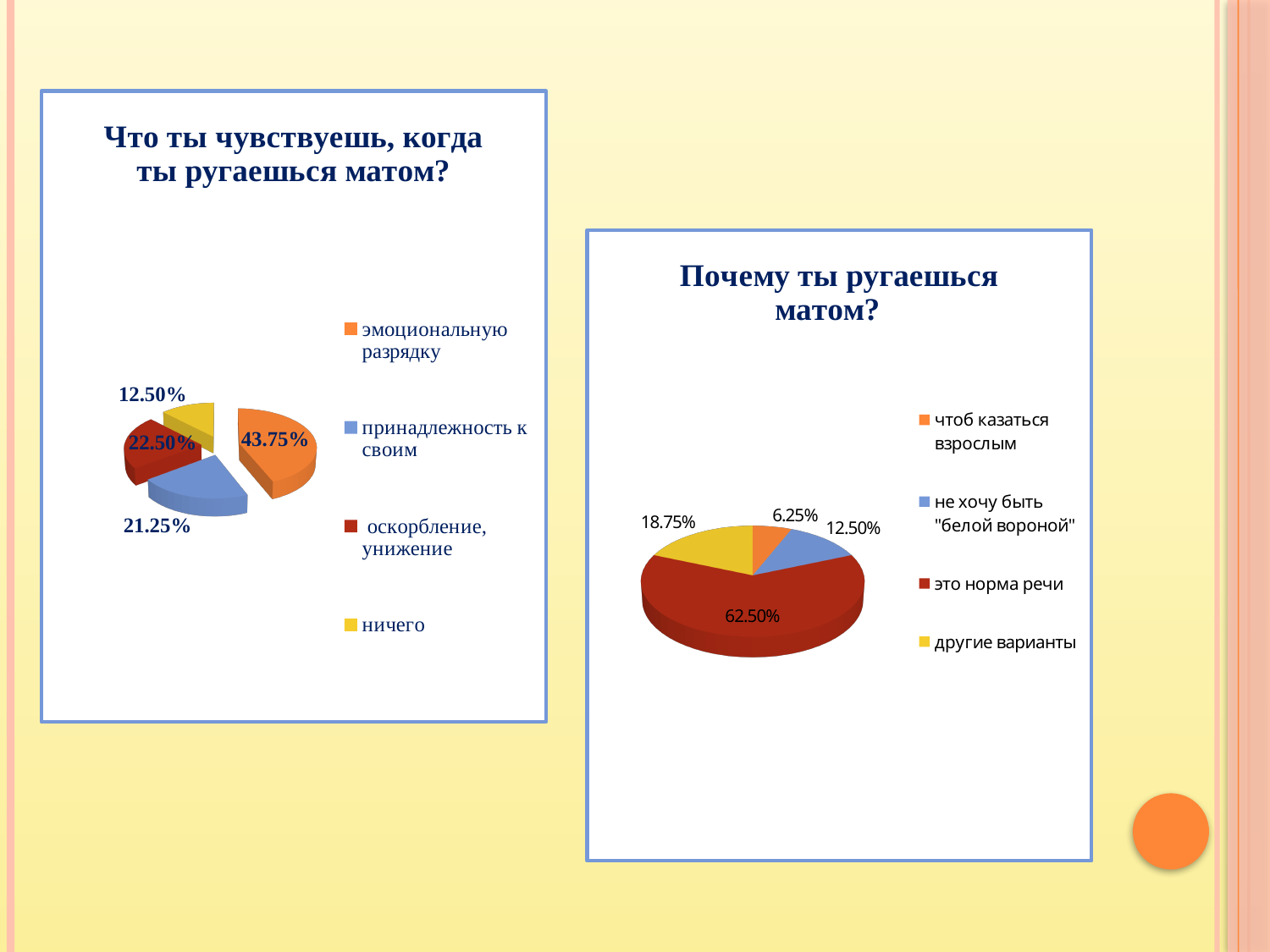
In the chart titled "Почему ты ругаешься матом?", what is the difference between the shares for "это норма речи" and "другие варианты"? 43.75% What type of chart is the chart titled "Почему ты ругаешься матом?"? pie chart In the chart titled "Что ты чувствуешь, когда ты ругаешься матом?", which category has the smallest share? ничего In the chart titled "Что ты чувствуешь, когда ты ругаешься матом?", what percentage is shown for "ничего"? 12.50% In the chart titled "Что ты чувствуешь, когда ты ругаешься матом?", what percentage is shown for "эмоциональную разрядку"? 43.75% In the chart titled "Почему ты ругаешься матом?", what percentage is shown for "это норма речи"? 62.50% In the chart titled "Почему ты ругаешься матом?", which category has the largest share? это норма речи In the chart titled "Что ты чувствуешь, когда ты ругаешься матом?", what is the difference between the shares for "эмоциональную разрядку" and "принадлежность к своим"? 22.50% In the chart titled "Что ты чувствуешь, когда ты ругаешься матом?", which category has the largest share? эмоциональную разрядку In the chart titled "Почему ты ругаешься матом?", which is larger: "другие варианты" or "не хочу быть "белой вороной""? другие варианты In the chart titled "Что ты чувствуешь, когда ты ругаешься матом?", how many categories does the legend list? 4 In the chart titled "Почему ты ругаешься матом?", what percentage is shown for "чтоб казаться взрослым"? 6.25%